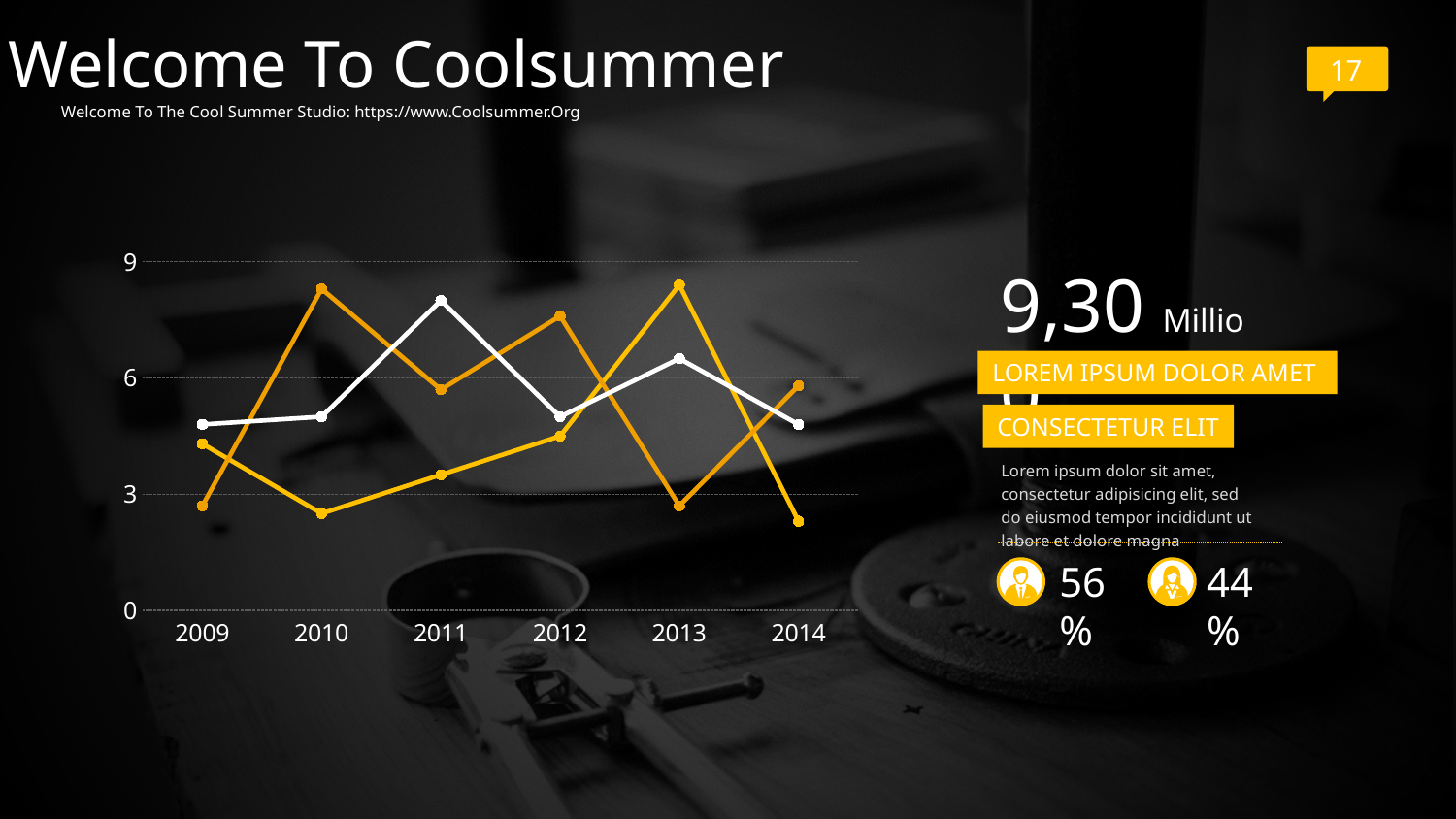
How many lines are plotted on the chart? 3 What is the highest value labelled on the y axis of the chart? 9 Does the white line rise or fall from 2009 to 2011? rise Is the value of the white line for 2014 greater or less than 3? greater Does the white line rise or fall from 2013 to 2014? fall In which year does the white line reach its highest value? 2011 How many years are shown on the x axis of the chart? 6 What is the first year shown on the x axis of the chart? 2009 Is the value of the white line for 2009 greater or less than 6? less What kind of chart is shown on the slide? line chart For 2011, is the white line's value larger or smaller than the values of the orange lines? larger Is the value of the white line for 2011 greater or less than 6? greater